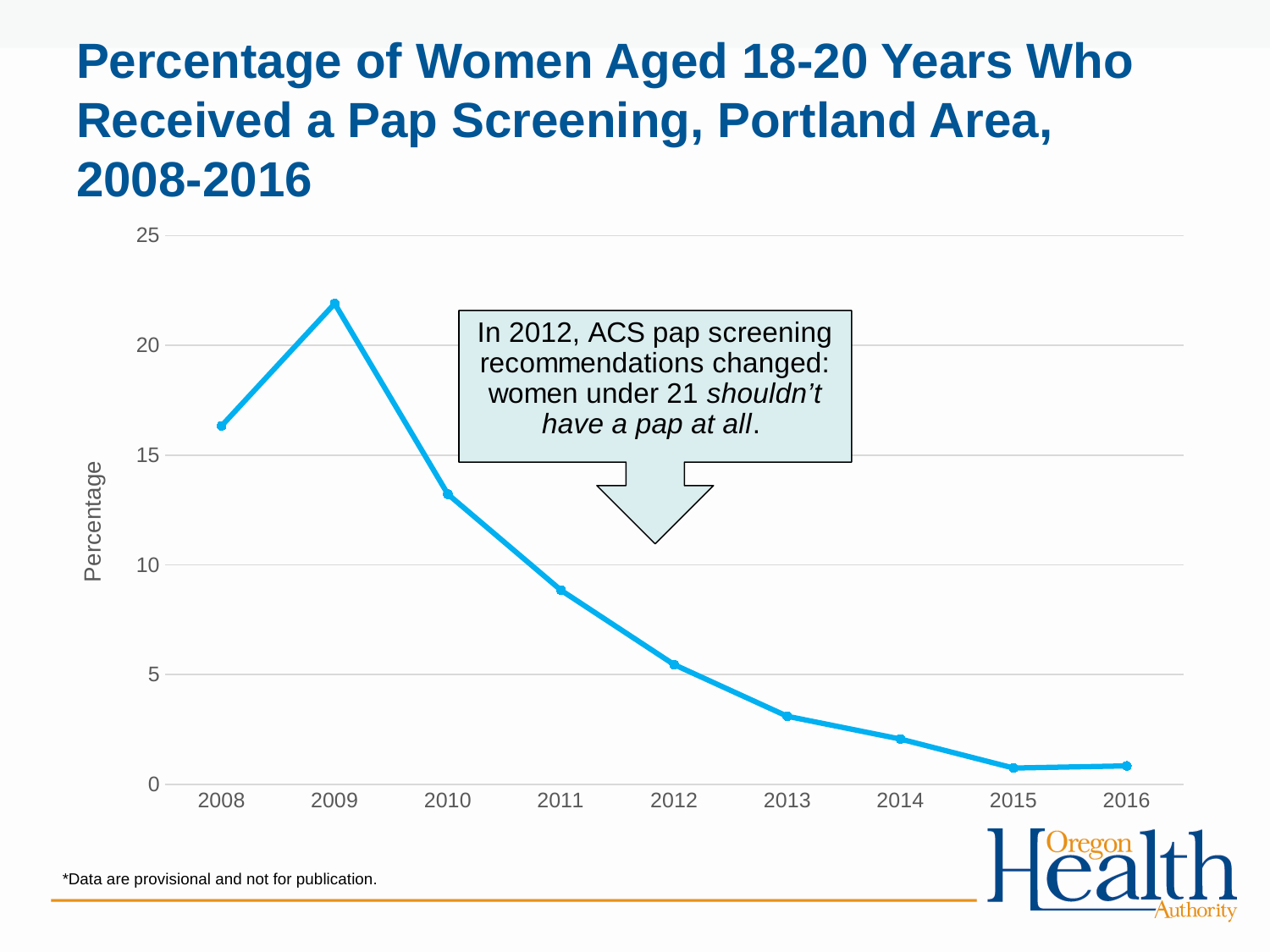
Is the value for 2008 greater or less than 15? greater Is the value for 2010 greater or less than 15? less What is the label on the y axis of the chart? Percentage Which year has the larger value, 2012 or 2014? 2012 Which year has the highest percentage of women aged 18-20 who received a Pap screening? 2009 How many years are plotted on the x axis? 9 What kind of chart is shown on the slide? line chart Is the value for 2011 greater or less than 10? less Which year has the larger value, 2008 or 2010? 2008 Do the values generally rise or fall from 2009 to 2016? fall